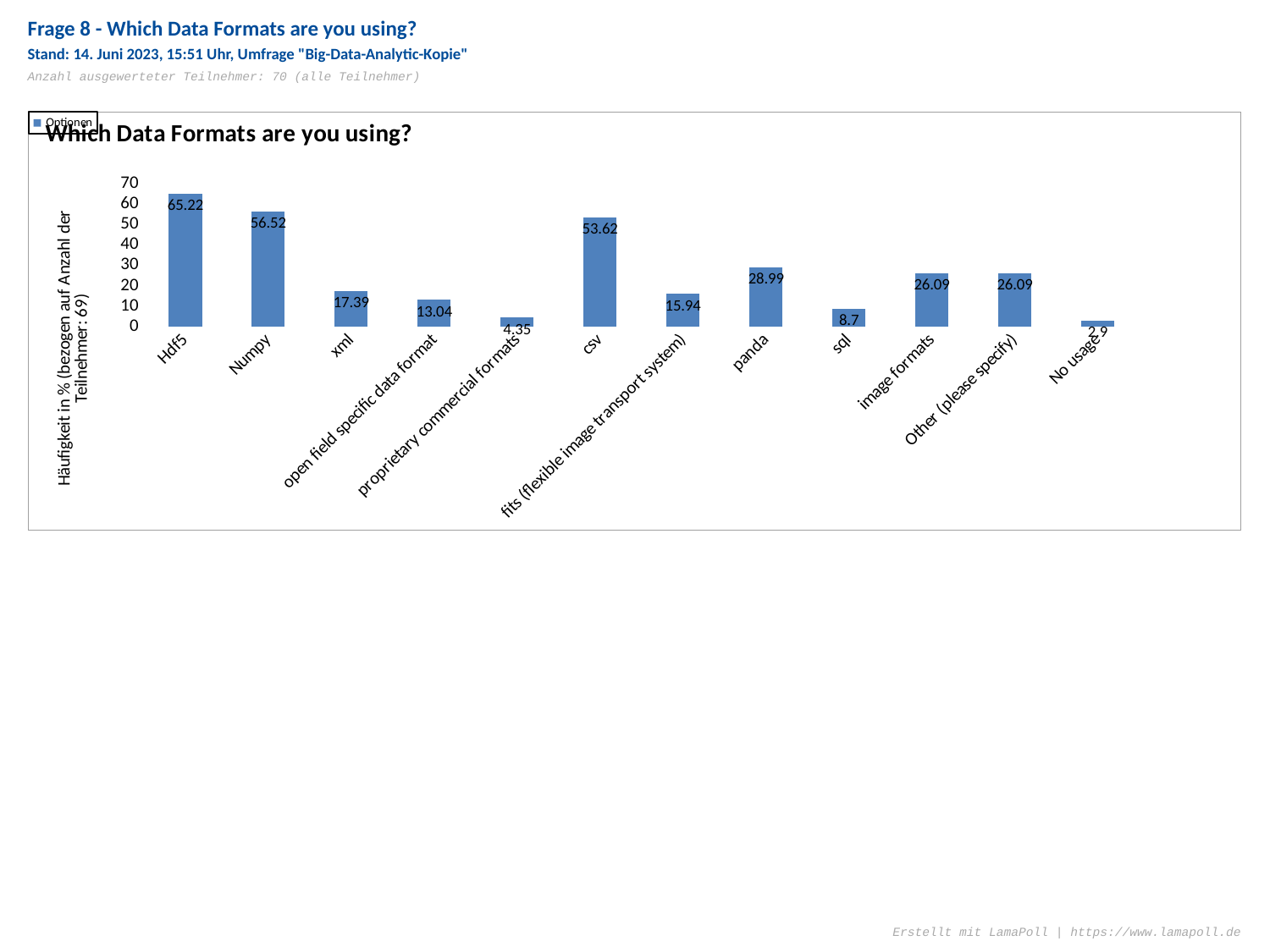
What is the value for Hdf5? 65.22 Which category has the highest value? Hdf5 Which category has the lowest value? No usage What is the value for sql? 8.7 What is the title of the chart? Which Data Formats are you using? What is the value for panda? 28.99 What kind of chart is shown? bar chart Which is larger, the value for xml or the value for fits (flexible image transport system)? xml Is the value for Numpy greater or less than 50? greater What is the value for csv? 53.62 How many categories are shown on the x axis? 12 What is the difference between the values for Hdf5 and Numpy? 8.7